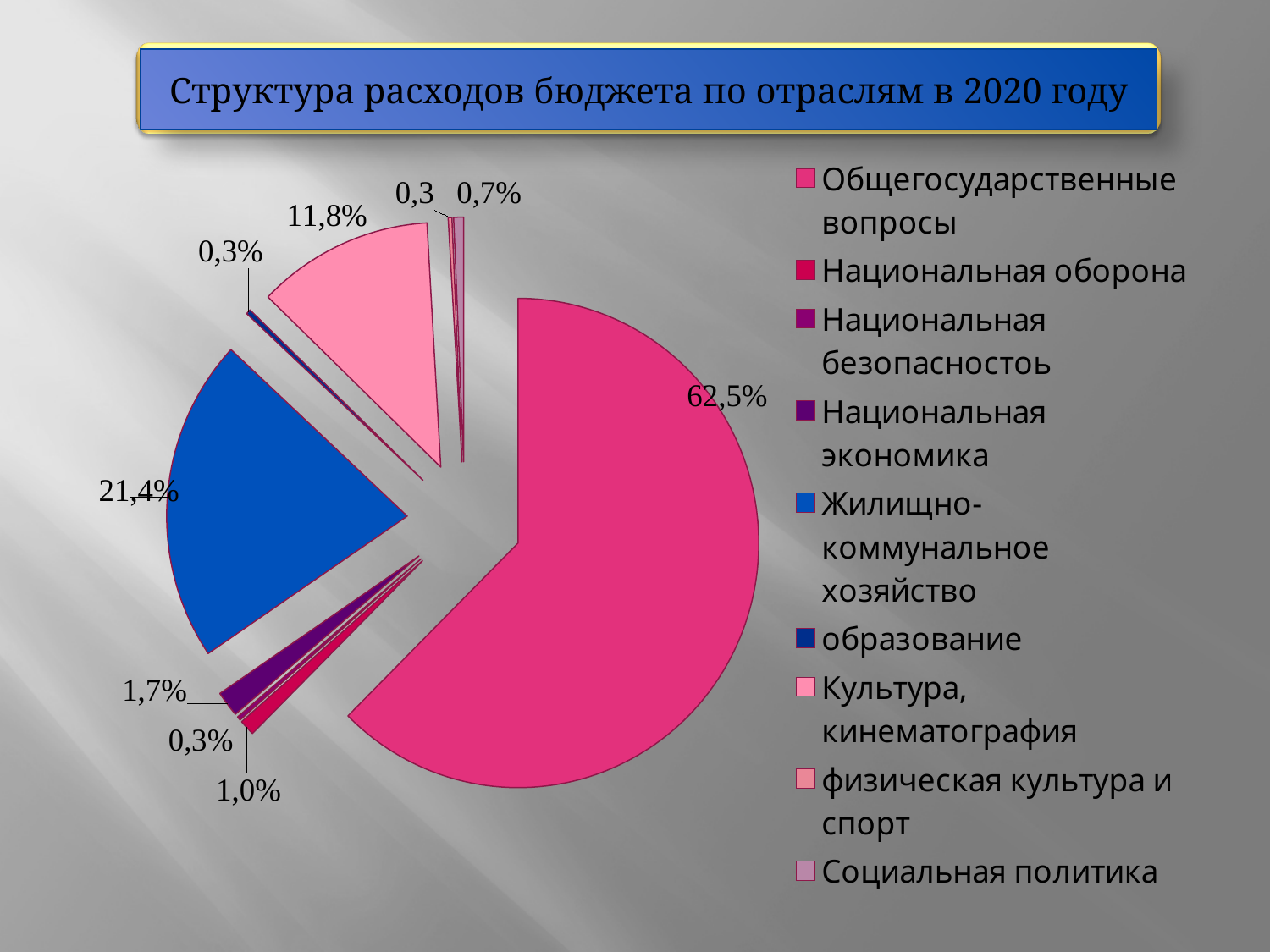
What colour is the slice for Жилищно-коммунальное хозяйство? blue What is the difference in percentage points between Общегосударственные вопросы and Жилищно-коммунальное хозяйство? 41,1 Which is larger: Жилищно-коммунальное хозяйство or Культура, кинематография? Жилищно-коммунальное хозяйство Which category has the largest share of the pie? Общегосударственные вопросы What is the value for Культура, кинематография? 11,8% What is the value for Национальная экономика? 1,7% What is the value for Социальная политика? 0,7% What is the value for Жилищно-коммунальное хозяйство? 21,4% What share of the pie is Общегосударственные вопросы? 62,5% What kind of chart is shown on the slide? pie chart How many categories does the legend list? 9 What is the title of the chart? Структура расходов бюджета по отраслям в 2020 году